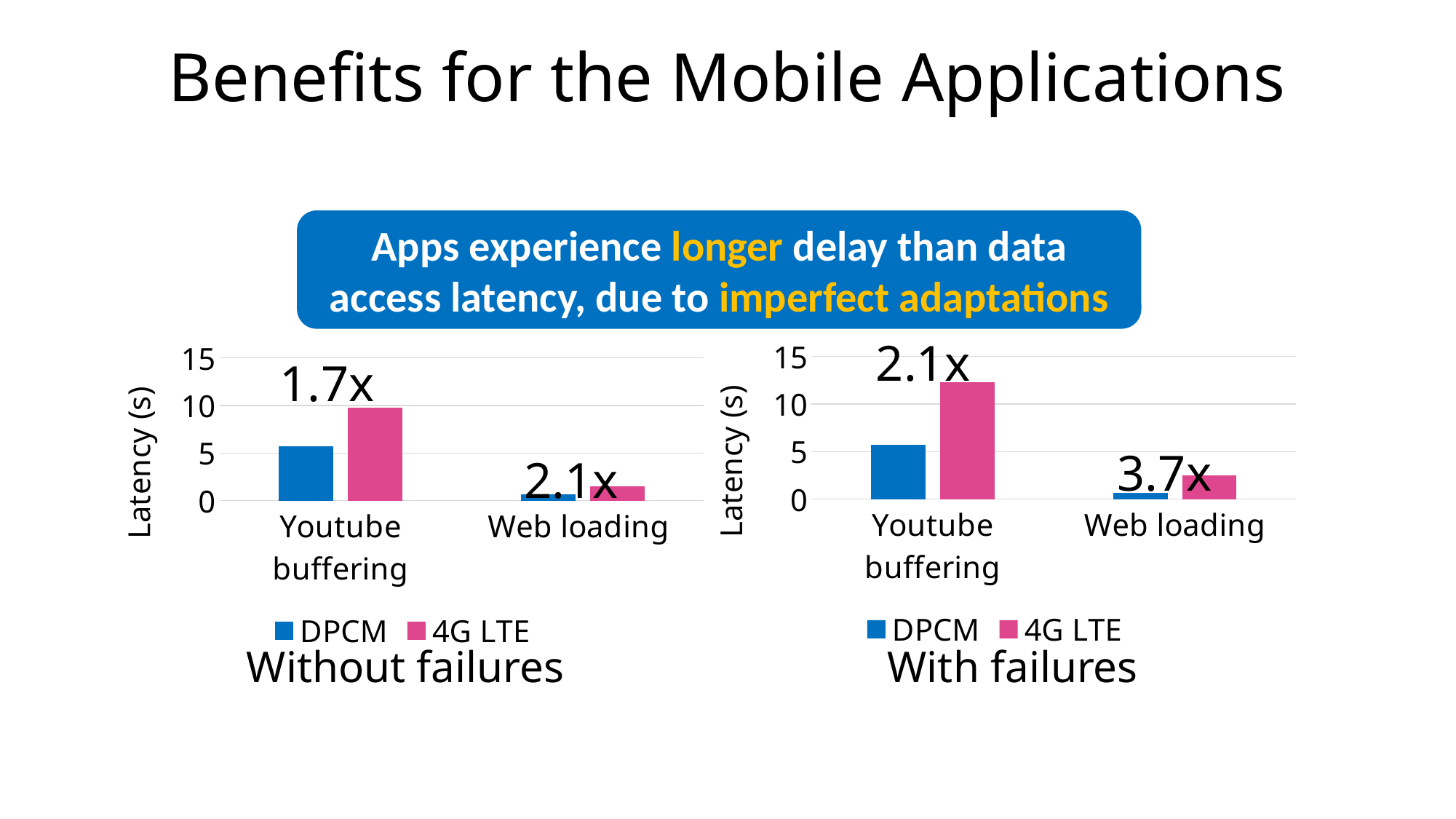
How many series does the legend of the 'Without failures' chart list? 2 What type of chart is the 'Without failures' chart? Bar chart In the 'Without failures' chart, which series has the higher latency for Youtube buffering, DPCM or 4G LTE? 4G LTE In the 'Without failures' chart, what multiplier is printed above the Youtube buffering bars? 1.7x In the 'With failures' chart, is the 4G LTE value for Youtube buffering greater or less than 10? greater In the 'With failures' chart, which bar is the tallest? 4G LTE for Youtube buffering In the 'With failures' chart, is the DPCM value for Web loading greater or less than 5? less In the 'Without failures' chart, what multiplier is printed above the Web loading bars? 2.1x In the 'With failures' chart, what multiplier is printed above the Youtube buffering bars? 2.1x How many categories are shown on the x axis of the 'With failures' chart? 2 In the 'With failures' chart, what multiplier is printed above the Web loading bars? 3.7x In the 'Without failures' chart, is the 4G LTE value for Web loading greater or less than 5? less